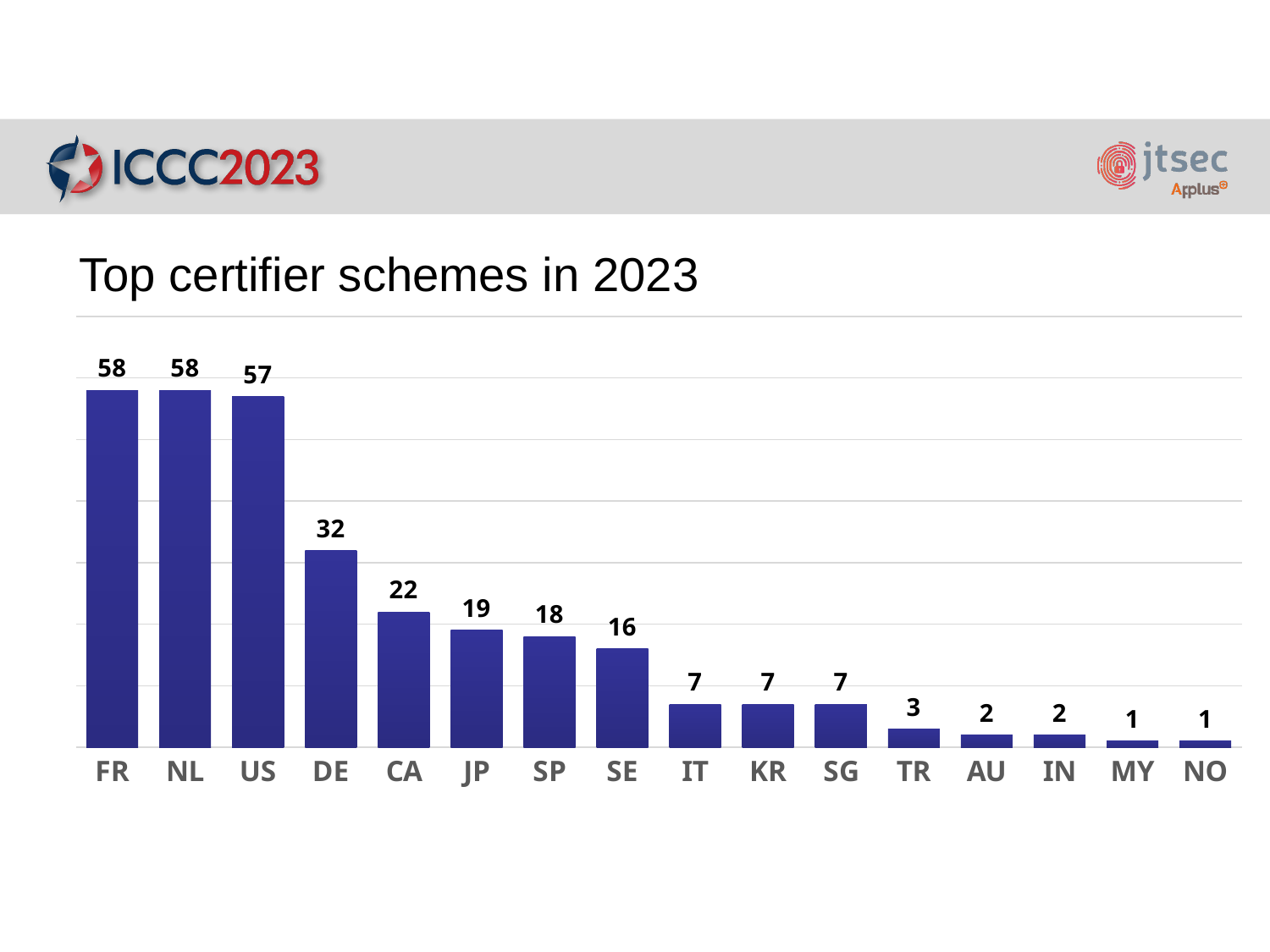
What is the difference between the values for DE and CA? 10 What kind of chart is shown on the slide? Bar chart Which categories have the lowest value? MY and NO Which categories have the highest value? FR and NL Which is larger, the value for JP or the value for SP? JP What is the value for SE? 16 What is the value for DE? 32 What is the value for TR? 3 What is the difference between the values for US and SE? 41 What is the title of the slide? Top certifier schemes in 2023 How many categories are shown on the x axis? 16 What is the value for CA? 22